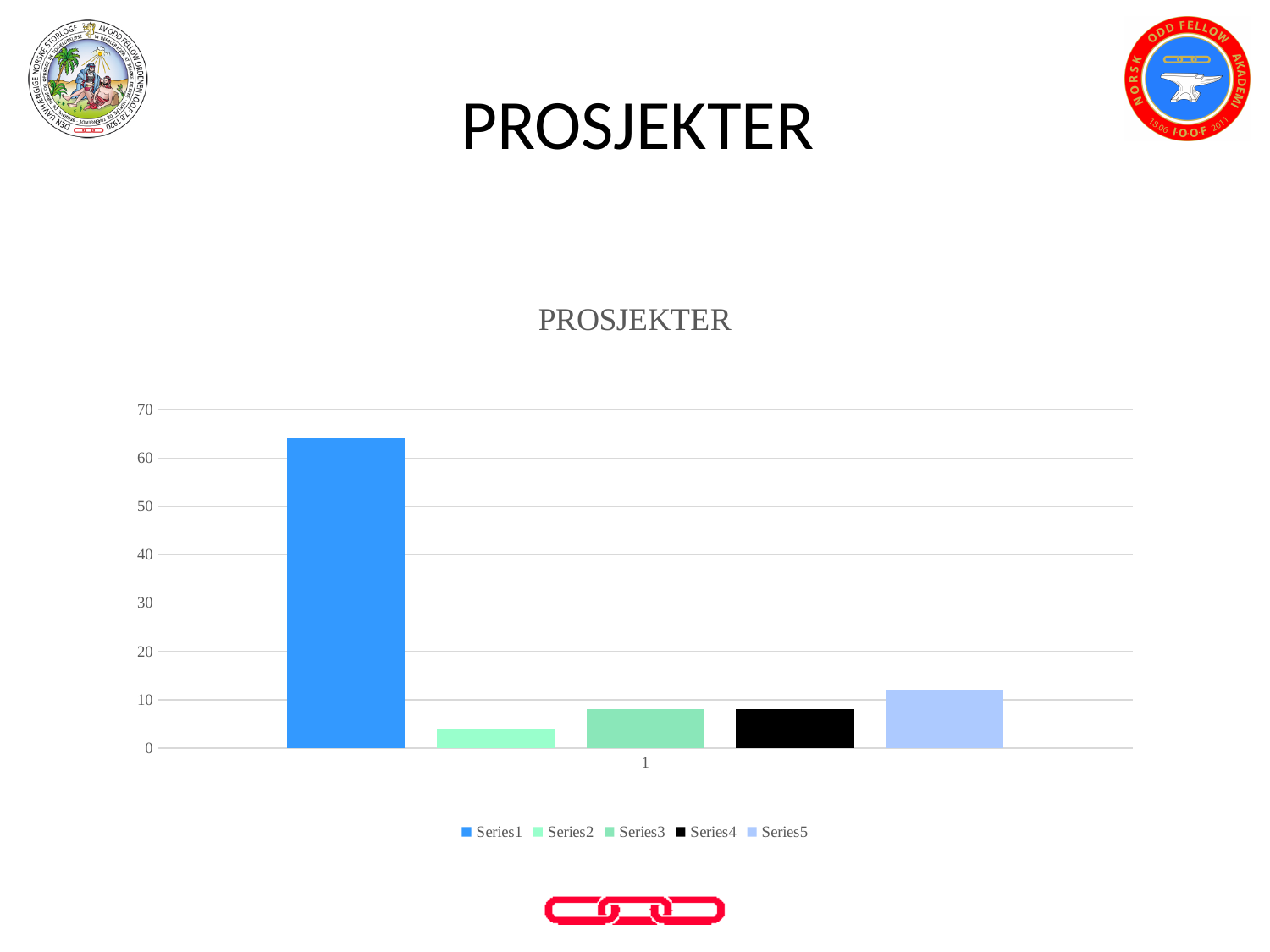
What kind of chart is shown on the slide? bar chart Is the value for Series1 greater or less than 60? greater How many series does the legend list? 5 Is the value for Series5 greater or less than 10? greater Which is larger, the value for Series5 or the value for Series2? Series5 Is the value for Series4 greater or less than 10? less Which is larger, the value for Series1 or the value for Series5? Series1 Which series has the highest value? Series1 Which series has the lowest value? Series2 What is the title of the chart? PROSJEKTER How many categories are shown on the x axis? 1